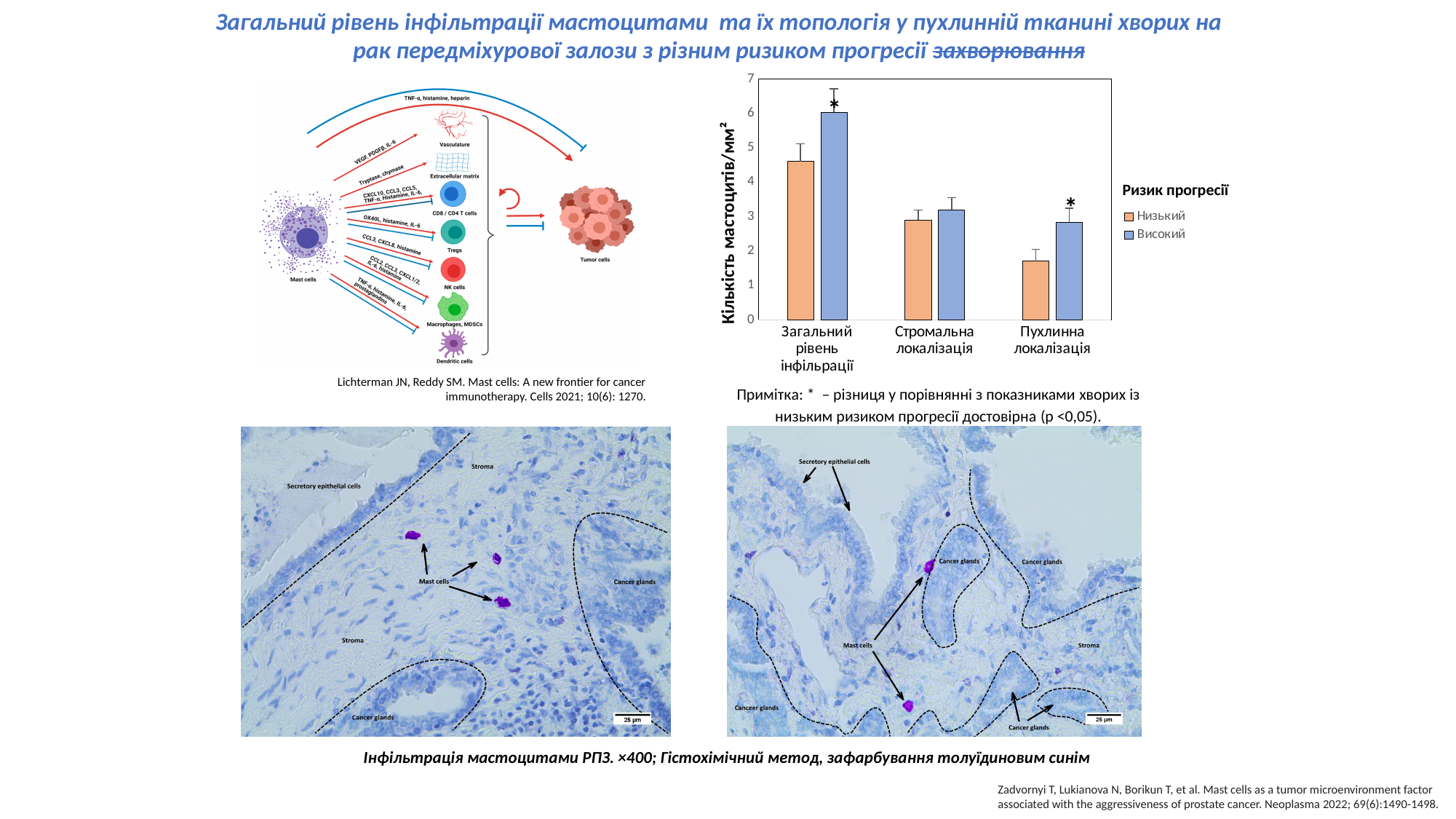
How many categories are shown on the x axis of the bar chart? 3 What is the title of the y axis of the bar chart? Кількість мастоцитів/мм² In the category Пухлинна локалізація, which series has the larger value, Низький or Високий? Високий What are the two series named in the legend of the bar chart? Низький and Високий Is the value for Низький in the category Пухлинна локалізація greater or less than 2? less What kind of chart is shown on the slide? bar chart Is the value for Низький in the category Загальний рівень інфільрації greater or less than 4? greater Is the value for Високий in the category Загальний рівень інфільрації greater or less than 5? greater In the category Загальний рівень інфільрації, which series has the larger value, Низький or Високий? Високий For the Низький series, which category has the lowest value? Пухлинна локалізація How many series does the legend of the bar chart list? 2 For the Високий series, which category has the highest value? Загальний рівень інфільрації